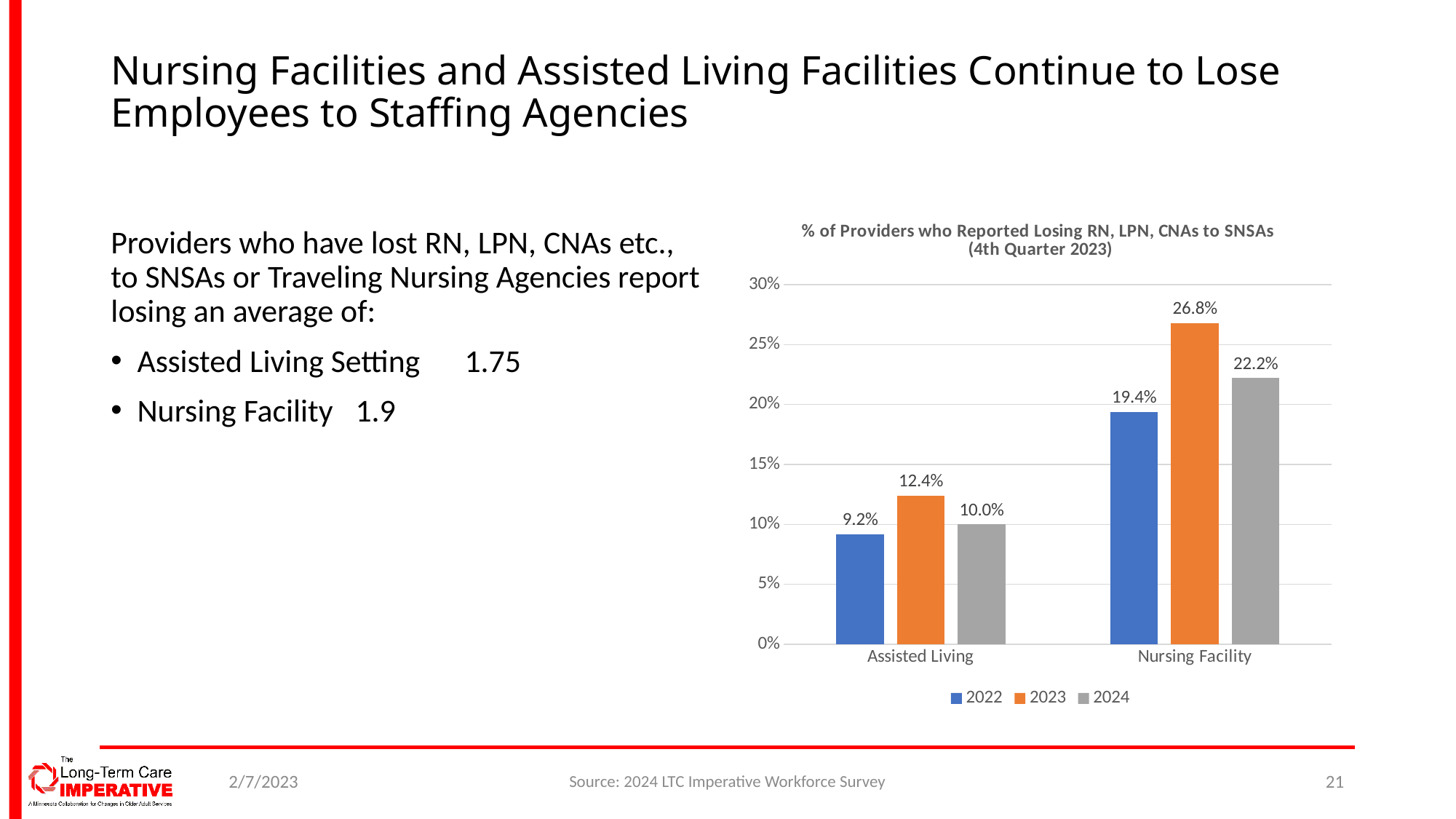
Which year has the lowest value for Assisted Living? 2022 What is the value for Nursing Facility in 2023? 26.8% What colour represents the 2023 series in the chart? Orange What is the value for Assisted Living in 2024? 10.0% Which is larger, the 2022 value for Nursing Facility or the 2024 value for Assisted Living? Nursing Facility 2022 How many categories are shown on the x axis? 2 What is the value for Nursing Facility in 2024? 22.2% Which year has the highest value for Nursing Facility? 2023 What percentage of Assisted Living providers reported losing RN, LPN, CNAs to SNSAs in 2022? 9.2% How many series does the legend list? 3 What is the difference between the Nursing Facility and Assisted Living values in 2023? 14.4% What kind of chart is shown on the slide? Bar chart